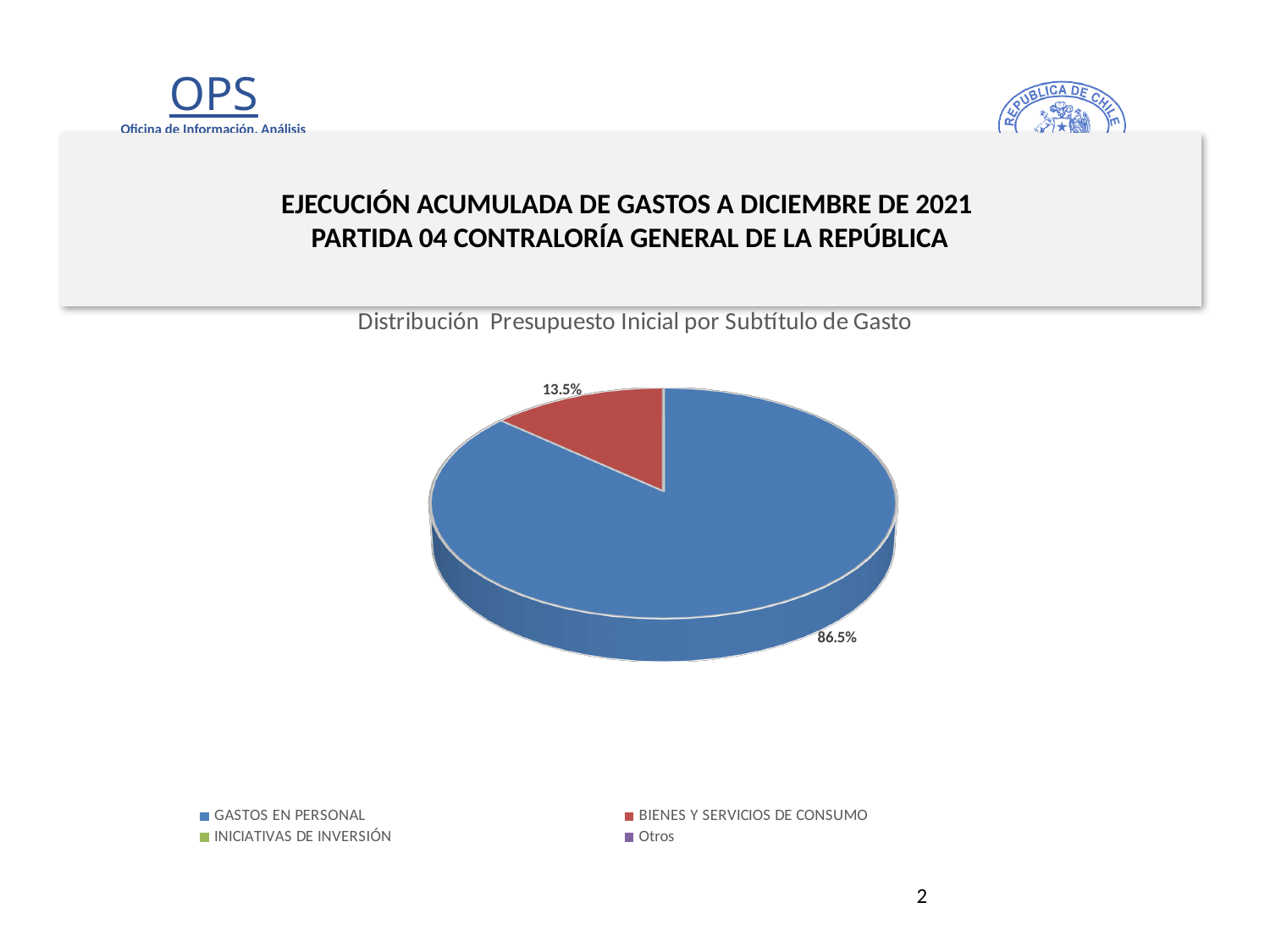
Is the share for GASTOS EN PERSONAL greater or less than 50%? greater Which is larger, the share for GASTOS EN PERSONAL or the share for BIENES Y SERVICIOS DE CONSUMO? GASTOS EN PERSONAL Which category has the largest slice of the pie? GASTOS EN PERSONAL What share of the pie does BIENES Y SERVICIOS DE CONSUMO represent? 13.5% What is the title of the chart? Distribución Presupuesto Inicial por Subtítulo de Gasto What kind of chart is shown on the slide? Pie chart What colour is the slice for BIENES Y SERVICIOS DE CONSUMO? Red Which of the labelled slices is the smallest? BIENES Y SERVICIOS DE CONSUMO What share of the pie does GASTOS EN PERSONAL represent? 86.5% How many categories are listed in the chart legend? 4 What is the difference in percentage points between the GASTOS EN PERSONAL slice and the BIENES Y SERVICIOS DE CONSUMO slice? 73.0 percentage points What percentage label is shown on the blue slice? 86.5%